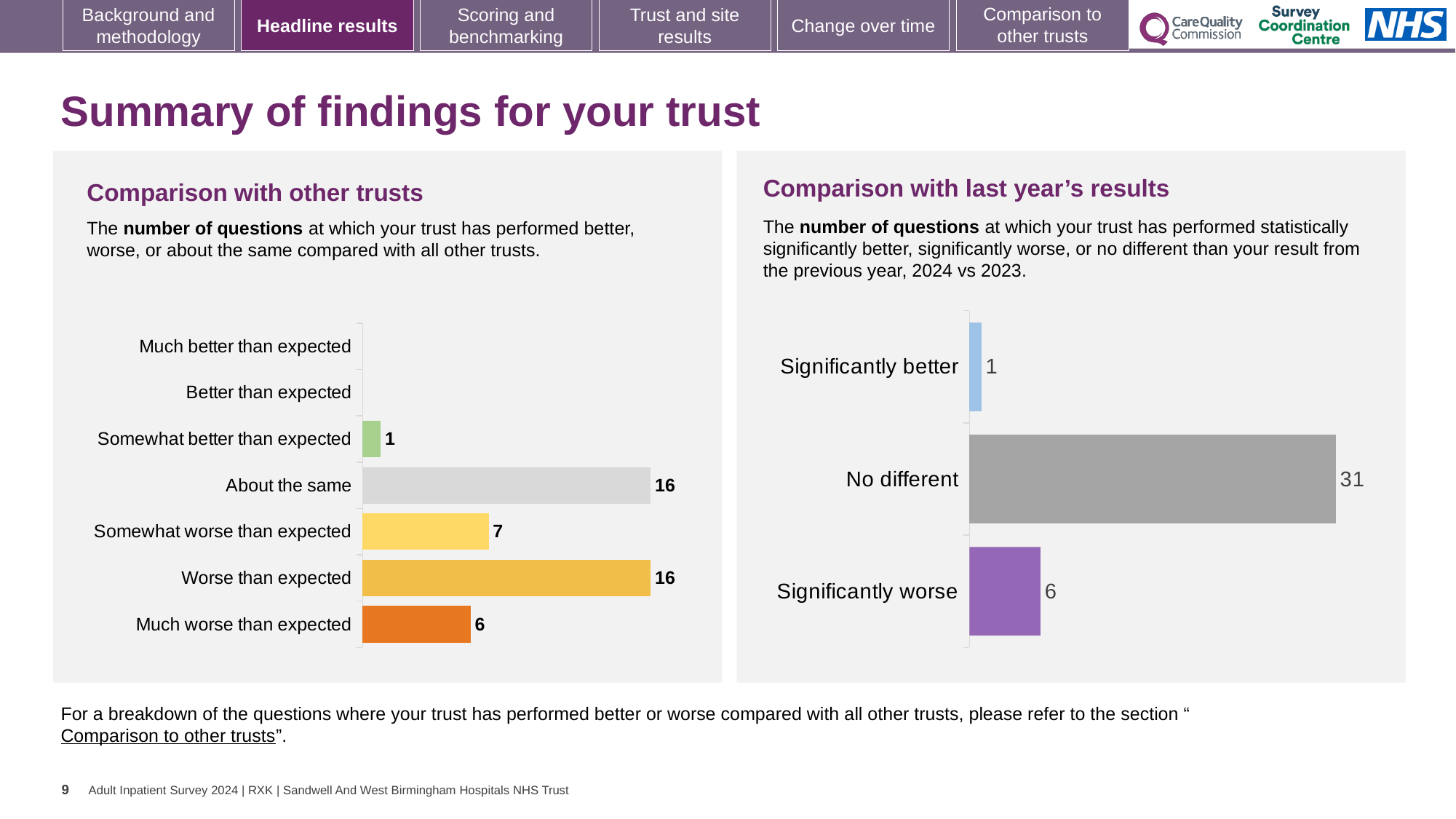
In the 'Comparison with other trusts' chart, what is the value for 'About the same'? 16 In the 'Comparison with other trusts' chart, what is the value for 'Much worse than expected'? 6 In the 'Comparison with last year's results' chart, what is the value for 'No different'? 31 In the 'Comparison with other trusts' chart, which is larger: 'Somewhat worse than expected' or 'Much worse than expected'? Somewhat worse than expected How many categories are listed on the axis of the 'Comparison with other trusts' chart? 7 In the 'Comparison with last year's results' chart, what is the difference between 'No different' and 'Significantly worse'? 25 How many categories are shown in the 'Comparison with last year's results' chart? 3 In the 'Comparison with last year's results' chart, which category has the highest value? No different In the 'Comparison with other trusts' chart, what is the value for 'Somewhat worse than expected'? 7 In the 'Comparison with other trusts' chart, what is the difference between 'Worse than expected' and 'Somewhat worse than expected'? 9 What kind of chart is the 'Comparison with other trusts' chart? Bar chart In the 'Comparison with last year's results' chart, which category has the lowest value? Significantly better